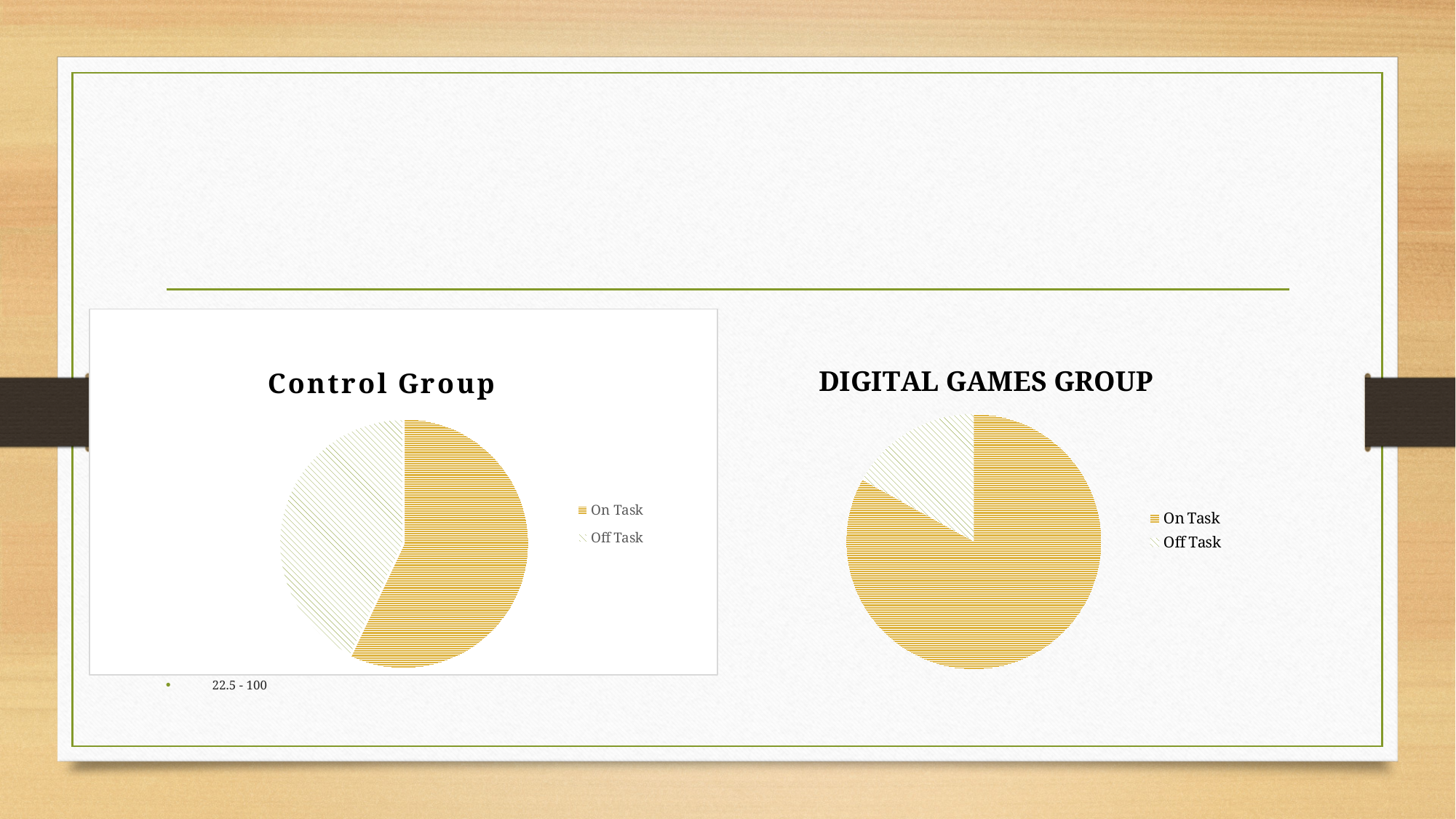
In the DIGITAL GAMES GROUP chart, which slice is the smallest? Off Task What kind of chart is the DIGITAL GAMES GROUP chart? pie chart How many slices does the DIGITAL GAMES GROUP pie chart have? 2 How many slices does the Control Group pie chart have? 2 What kind of chart is the Control Group chart? pie chart In the DIGITAL GAMES GROUP chart, is the On Task slice larger or smaller than the Off Task slice? larger What are the two legend entries in the Control Group chart? On Task, Off Task In the Control Group chart, which slice is the largest? On Task In the DIGITAL GAMES GROUP chart, which slice is the largest? On Task In the Control Group chart, which slice is the smallest? Off Task What is the title of the pie chart on the left of the slide? Control Group How many entries does the legend of the DIGITAL GAMES GROUP chart list? 2